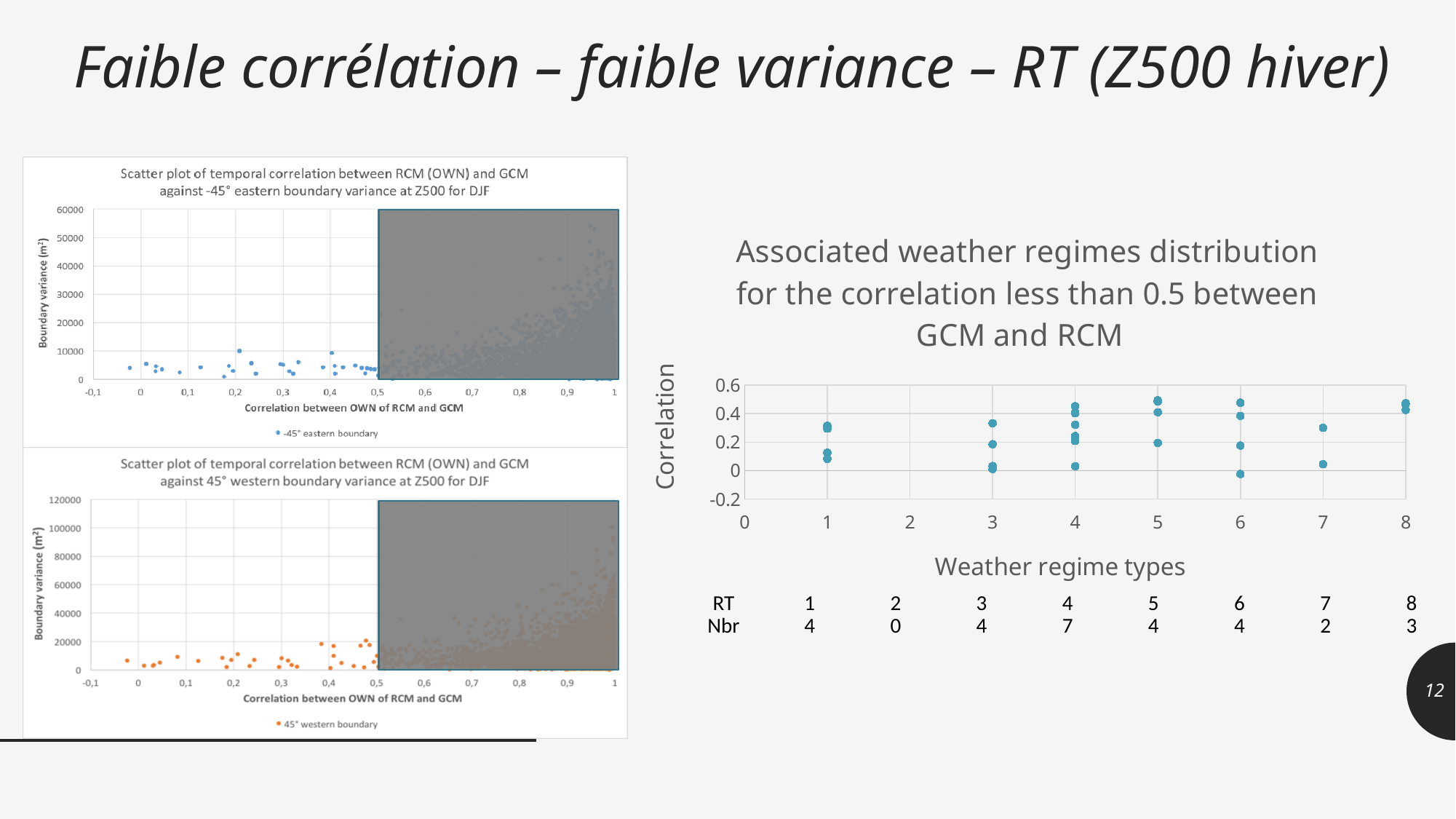
In the chart titled 'Associated weather regimes distribution for the correlation less than 0.5 between GCM and RCM', what is the label of the y axis? Correlation What kind of chart is the chart titled 'Associated weather regimes distribution for the correlation less than 0.5 between GCM and RCM'? scatter plot According to the table below the chart titled 'Associated weather regimes distribution for the correlation less than 0.5 between GCM and RCM', what is the difference in Nbr between RT 4 and RT 8? 4 In the chart titled 'Associated weather regimes distribution for the correlation less than 0.5 between GCM and RCM', is the highest correlation value for weather regime type 1 greater or less than 0.4? less According to the table below the chart titled 'Associated weather regimes distribution for the correlation less than 0.5 between GCM and RCM', how many points (Nbr) are there for RT 4? 7 In the chart titled 'Associated weather regimes distribution for the correlation less than 0.5 between GCM and RCM', what is the label of the x axis? Weather regime types In the bottom-left chart titled 'Scatter plot of temporal correlation between RCM (OWN) and GCM against 45° western boundary variance at Z500 for DJF', are all the orange points greater or less than 40000 on the boundary variance axis? less In the top-left chart titled 'Scatter plot of temporal correlation between RCM (OWN) and GCM against -45° eastern boundary variance at Z500 for DJF', are all the blue points greater or less than 20000 on the boundary variance axis? less What is the legend entry of the top-left chart titled 'Scatter plot of temporal correlation between RCM (OWN) and GCM against -45° eastern boundary variance at Z500 for DJF'? -45° eastern boundary According to the table below the chart titled 'Associated weather regimes distribution for the correlation less than 0.5 between GCM and RCM', which RT has the highest Nbr? 4 In the chart titled 'Associated weather regimes distribution for the correlation less than 0.5 between GCM and RCM', which weather regime type has no plotted points? 2